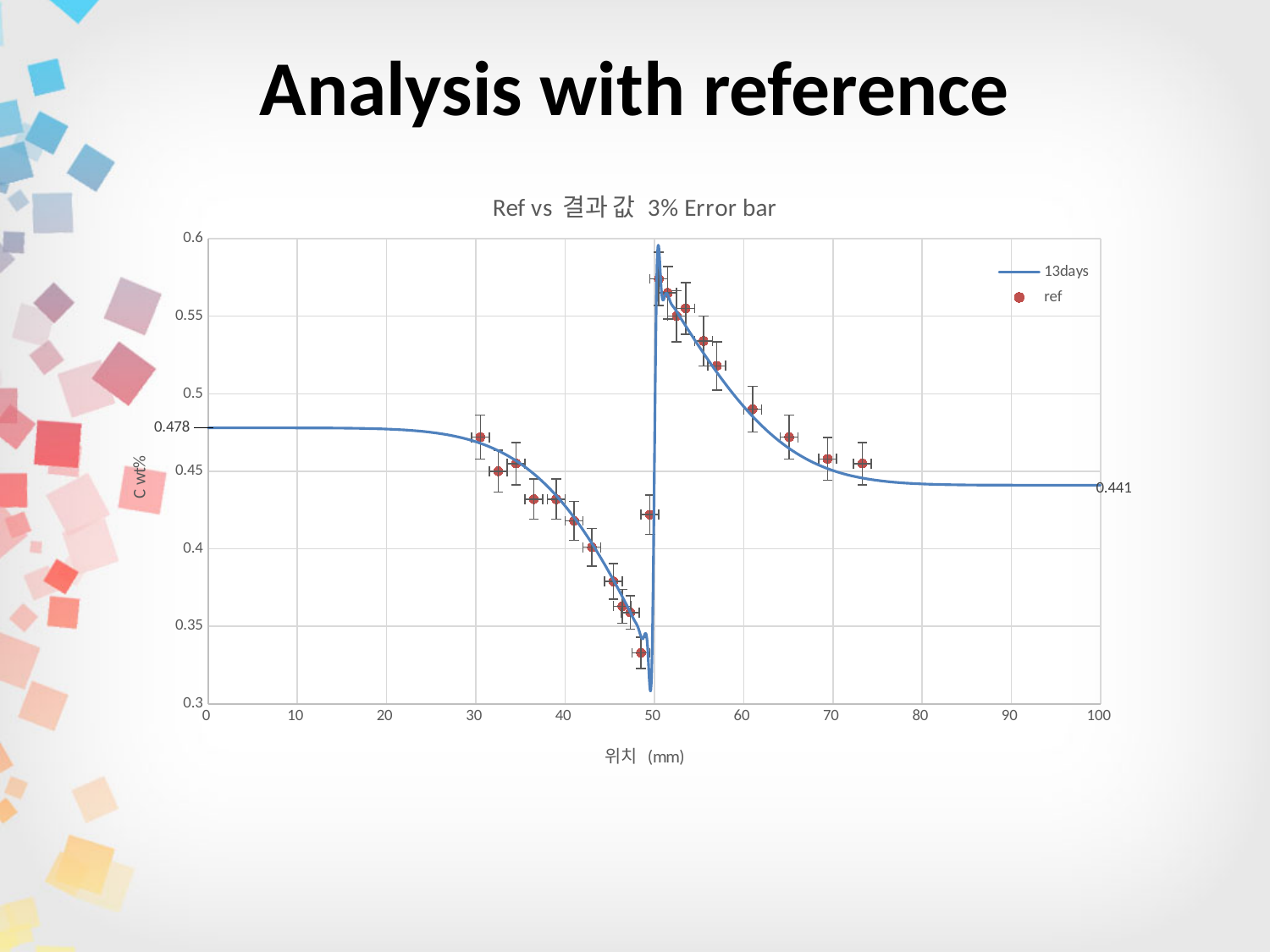
What is the value of the 13days line at position 0 mm? 0.478 What is the difference between the 13days values at 0 mm (0.478) and 100 mm (0.441)? 0.037 Is the highest ref point greater or less than 0.55? greater How many series does the legend list? 2 Is the lowest ref point greater or less than 0.35? less Which is larger for the 13days line: the value at 0 mm or the value at 100 mm? 0 mm What are the two entries in the chart legend? 13days and ref Is the value of the 13days line at 20 mm greater or less than 0.45? greater What kind of chart is shown on the slide? line chart What is the value of the 13days line at position 100 mm? 0.441 What is the title of the chart? Ref vs 결과 값 3% Error bar Between 30 mm and 48 mm, does the 13days line rise or fall? fall